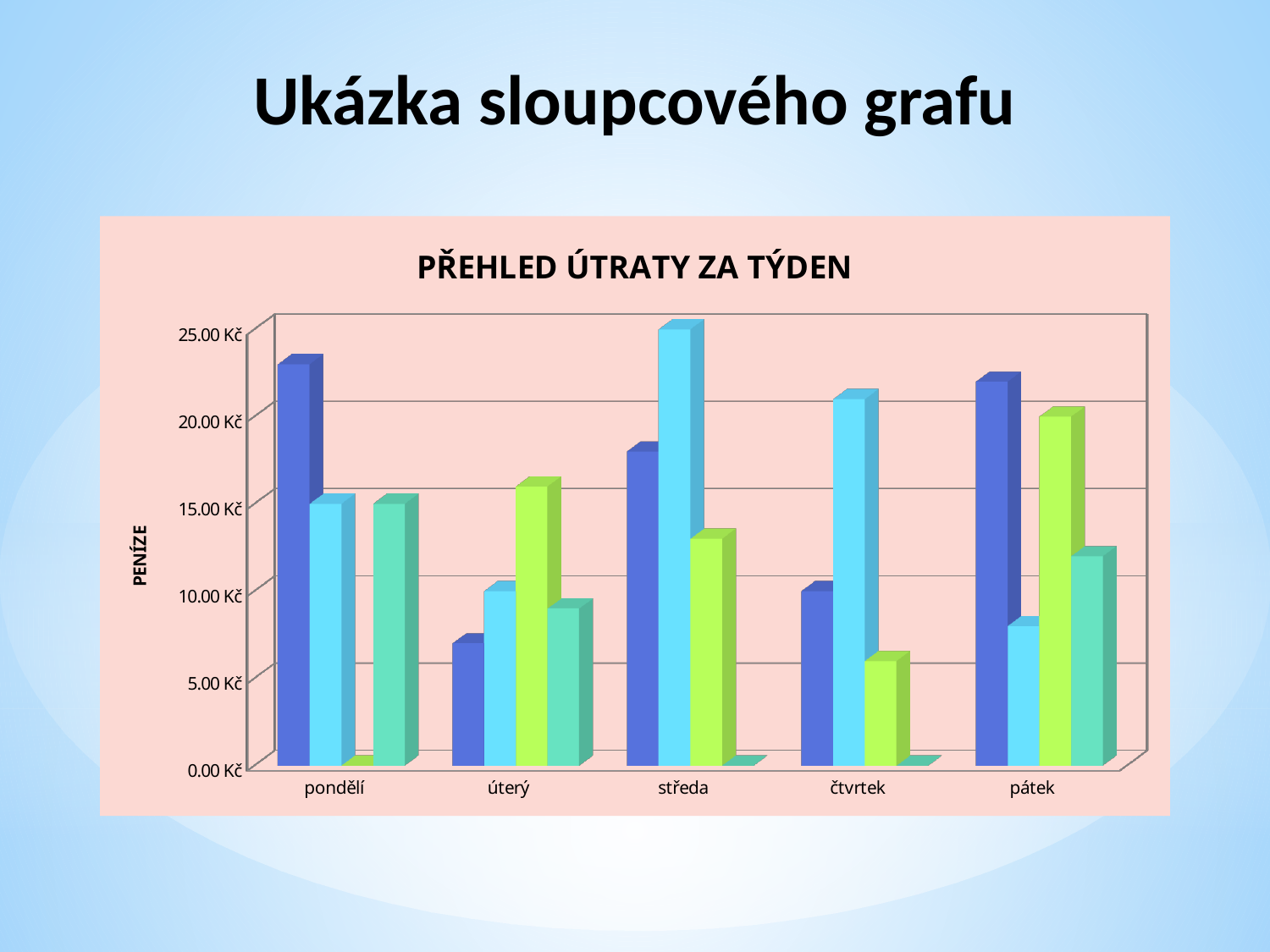
What is the label on the vertical axis of the chart? PENÍZE Is the value of the green bar for pátek greater or less than 15.00 Kč? greater Is the value of the dark blue bar for úterý greater or less than 10.00 Kč? less Is the value of the dark blue bar for pondělí greater or less than 20.00 Kč? greater For středa, which bar is taller: the dark blue bar or the light blue bar? The light blue bar For pátek, which bar is taller: the dark blue bar or the light blue bar? The dark blue bar What kind of chart is shown on the slide? Bar chart Among the light blue bars, which day has the highest value? středa What is the title of the chart? PŘEHLED ÚTRATY ZA TÝDEN How many days (categories) are shown on the x axis of the chart? 5